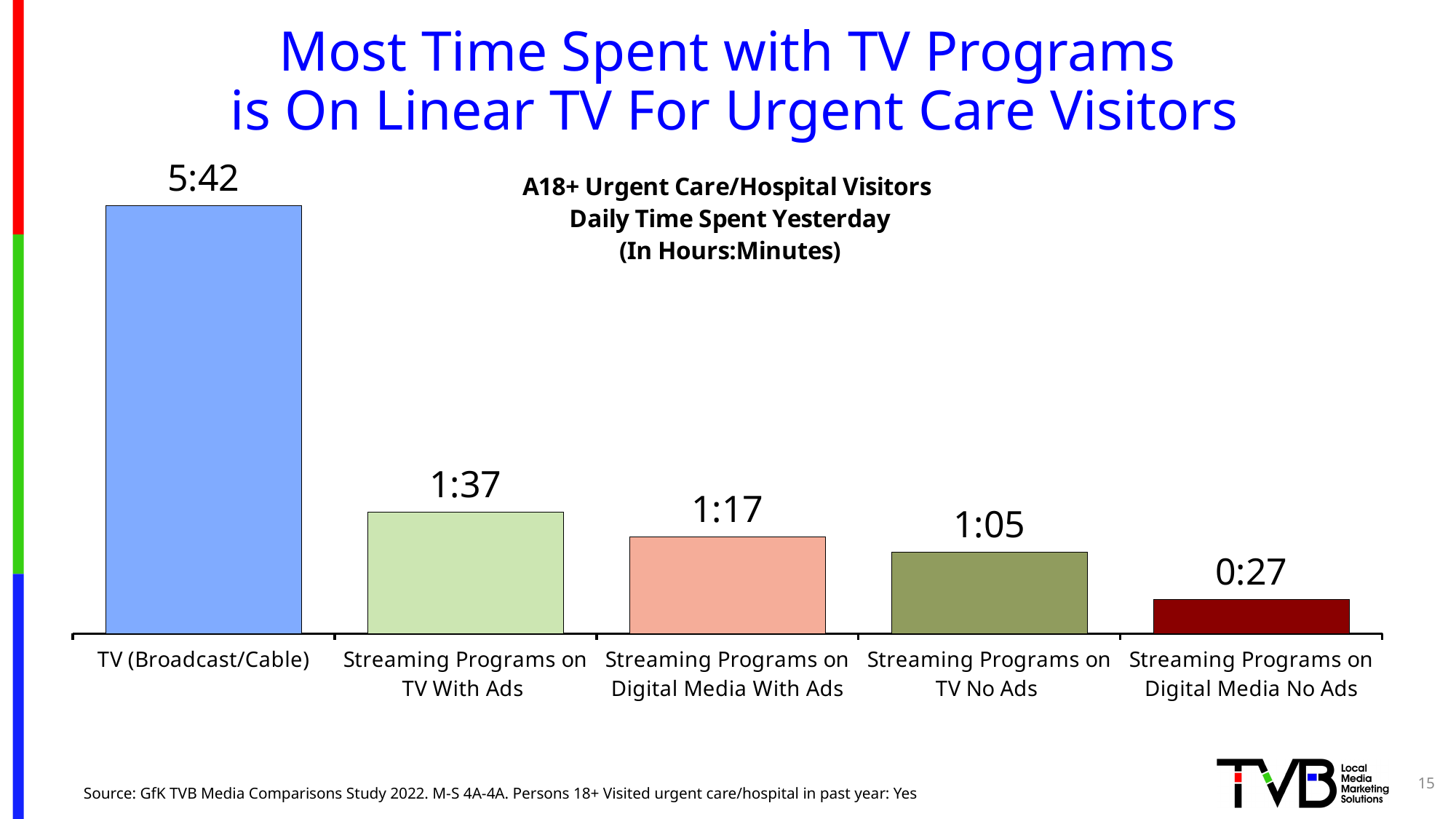
What is the daily time spent for TV (Broadcast/Cable)? 5:42 What is the daily time spent for Streaming Programs on Digital Media With Ads? 1:17 What type of chart is shown on the slide? Bar chart What is the daily time spent for Streaming Programs on TV With Ads? 1:37 What is the daily time spent for Streaming Programs on TV No Ads? 1:05 What is the title of the chart? A18+ Urgent Care/Hospital Visitors Daily Time Spent Yesterday (In Hours:Minutes) How much more daily time is spent on TV (Broadcast/Cable) than on Streaming Programs on TV With Ads? 4:05 Which has a higher daily time spent: Streaming Programs on Digital Media With Ads or Streaming Programs on TV No Ads? Streaming Programs on Digital Media With Ads What is the daily time spent for Streaming Programs on Digital Media No Ads? 0:27 Which category has the lowest daily time spent? Streaming Programs on Digital Media No Ads Which category has the highest daily time spent? TV (Broadcast/Cable) How many categories are shown in the chart? 5